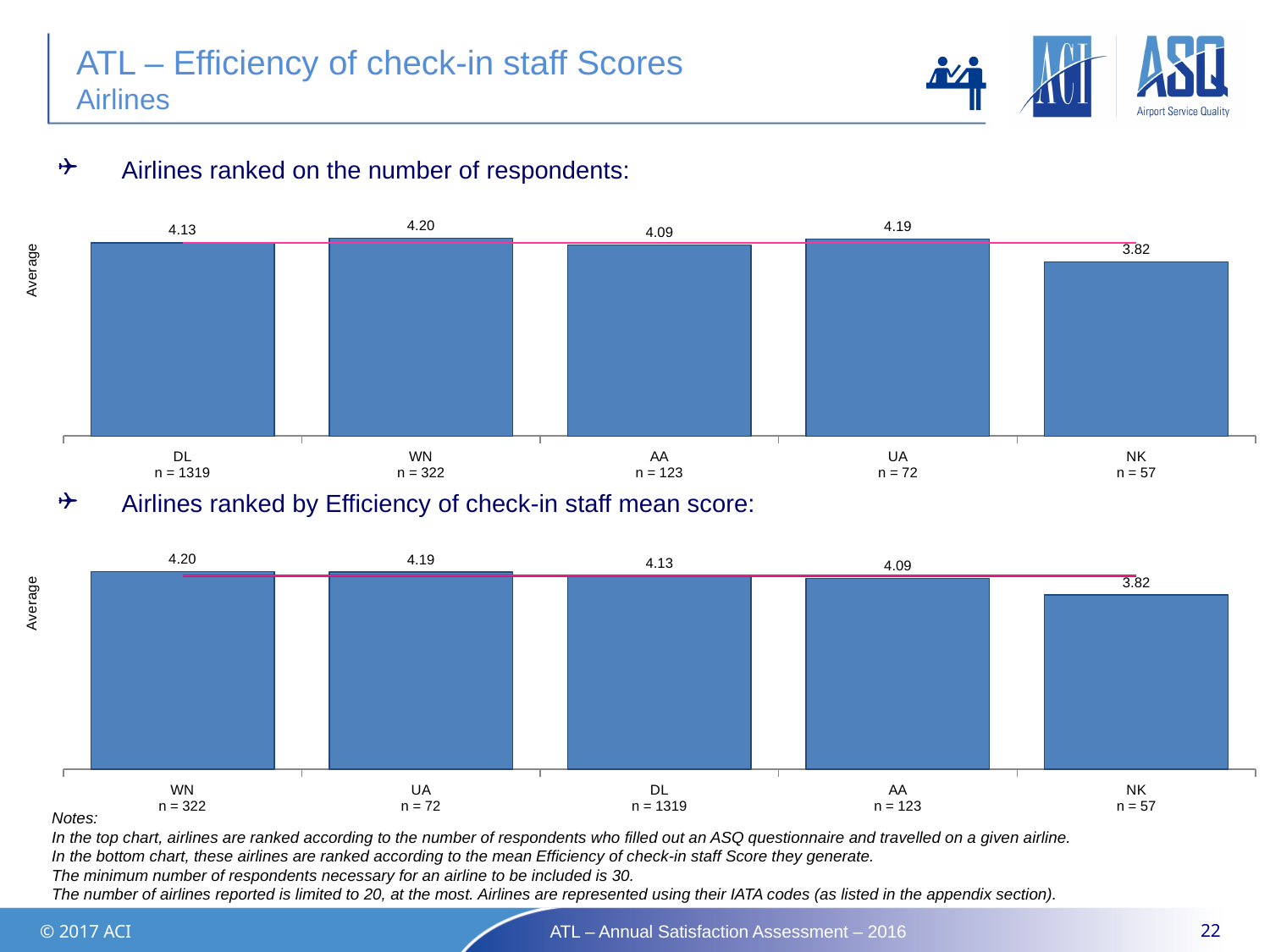
In the top chart (airlines ranked on the number of respondents), what is the average score for DL? 4.13 How many airlines are shown in the top chart (airlines ranked on the number of respondents)? 5 In the top chart (airlines ranked on the number of respondents), what is the average score for NK? 3.82 In the top chart (airlines ranked on the number of respondents), which airline has the lowest average score? NK In the top chart (airlines ranked on the number of respondents), which airline appears first on the x axis? DL In the bottom chart (airlines ranked by mean score), what is the average score for UA? 4.19 In the bottom chart (airlines ranked by mean score), which airline has the highest average score? WN In the top chart (airlines ranked on the number of respondents), which has a higher average score, DL or AA? DL In the bottom chart (airlines ranked by mean score), what is the difference between the scores of WN and NK? 0.38 In the bottom chart (airlines ranked by mean score), do the scores rise or fall from left to right? Fall What type of chart is the bottom chart (airlines ranked by mean score)? Bar chart In the top chart (airlines ranked on the number of respondents), how many respondents does WN have? n = 322